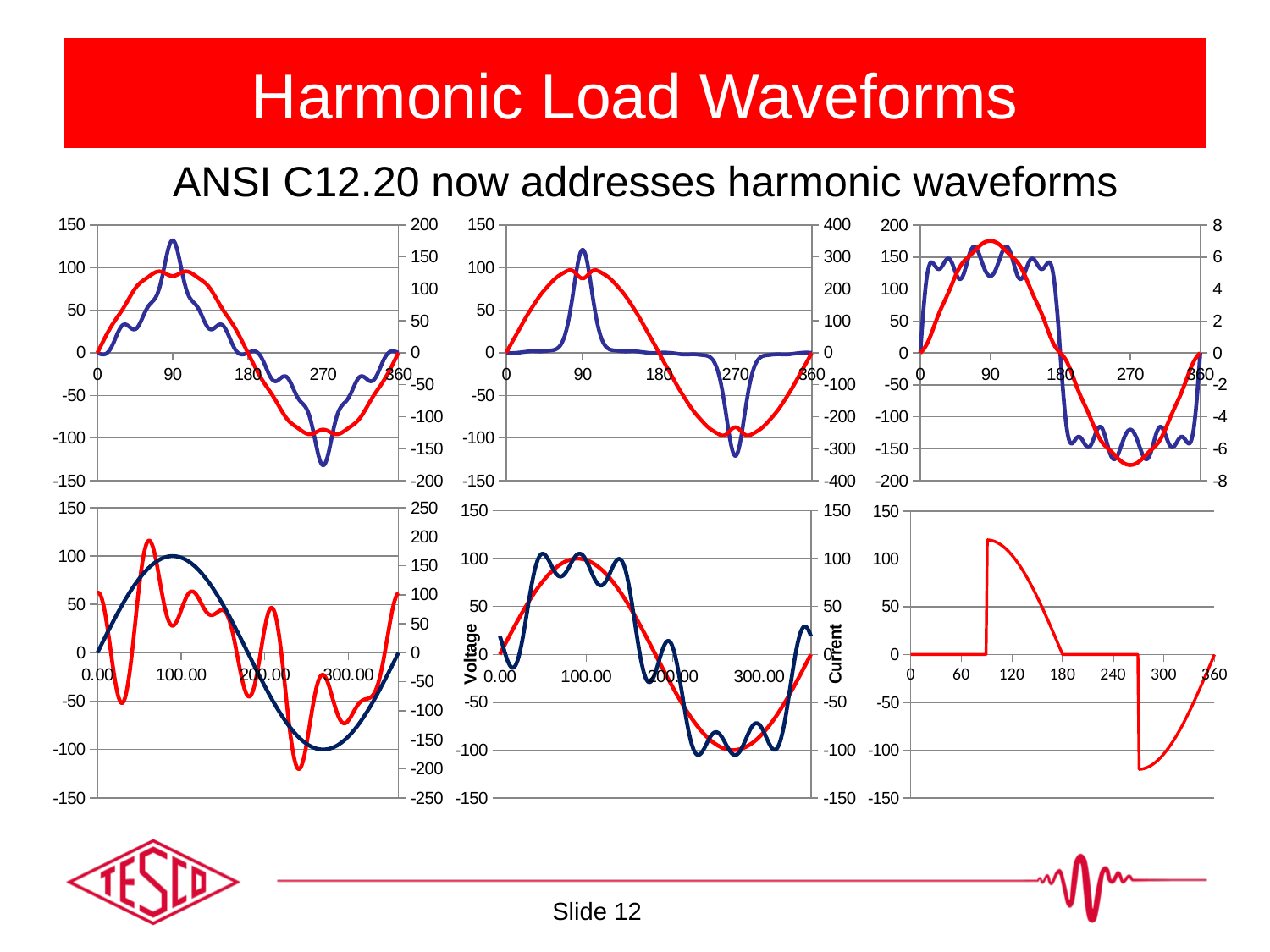
What kind of chart is the top-left chart on the slide? line chart In the bottom-middle chart, what is the label on the left vertical axis? Voltage In the top-left chart, is the peak value of the red curve at 90 on the left axis greater or less than 50? greater In the top-middle chart, is the peak value of the blue curve at 90 on the right axis greater or less than 200? greater In the top-right chart, is the peak value of the red curve at 90 on the left axis greater or less than 150? greater In the top-left chart, does the red curve rise or fall between x = 0 and x = 90? rise What is the maximum value shown on the right vertical axis of the top-right chart? 8 In the bottom-right chart, what is the value of the red line at x = 60? 0 How many charts are shown on the slide? 6 In the bottom-right chart, does the red line rise or fall between x = 120 and x = 180? fall